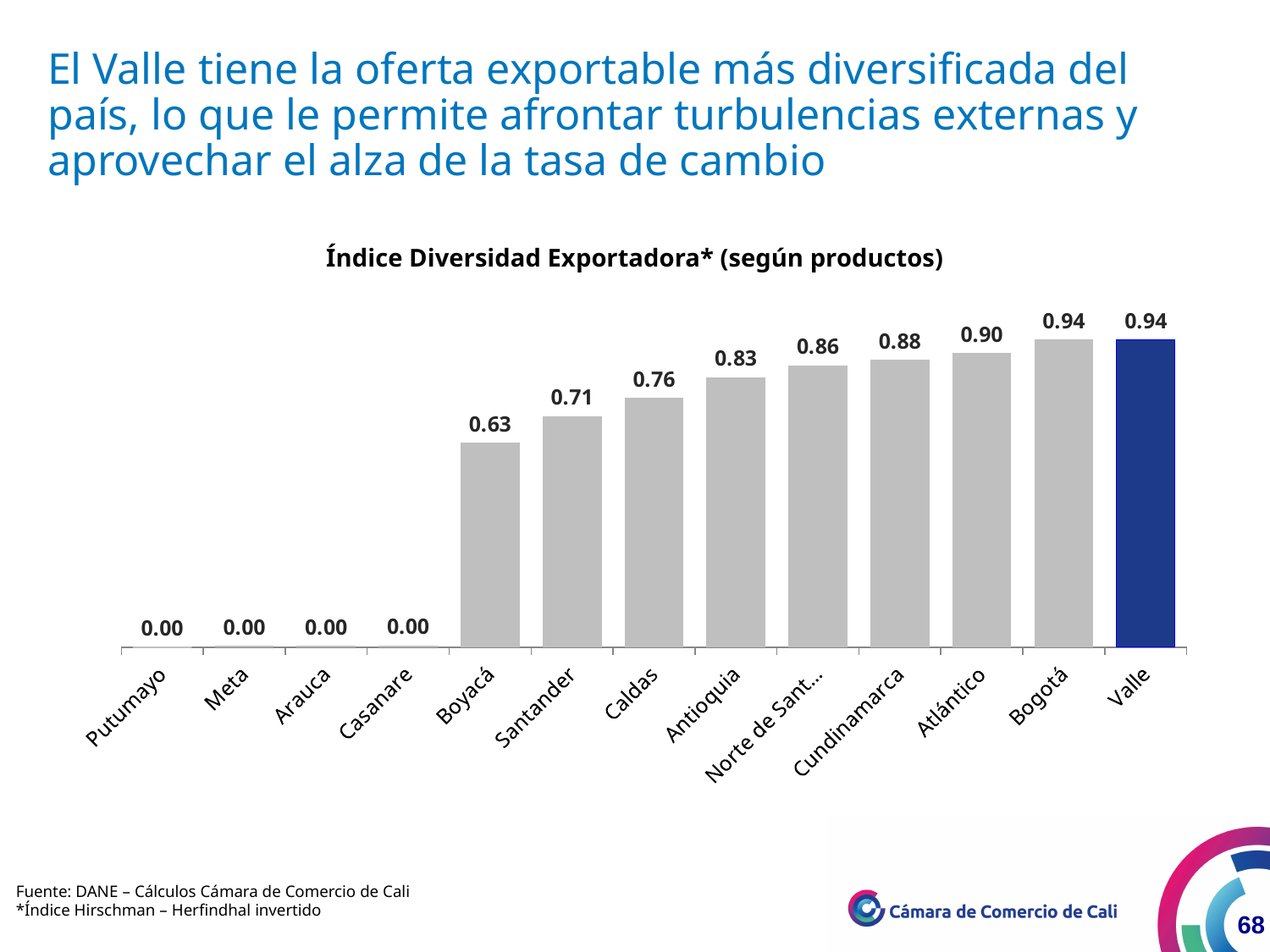
What is the value for Antioquia? 0.83 How many departments are shown on the chart? 13 What is the value for Valle? 0.94 What is the highest value shown on the chart? 0.94 What is the difference between the values for Valle and Boyacá? 0.31 Do the values rise or fall from left to right along the x axis? Rise What is the value for Casanare? 0.00 What is the difference between the values for Atlántico and Santander? 0.19 What is the value for Cundinamarca? 0.88 What is the value for Boyacá? 0.63 Which has a larger value, Caldas or Antioquia? Antioquia What kind of chart is shown on the slide? Bar chart